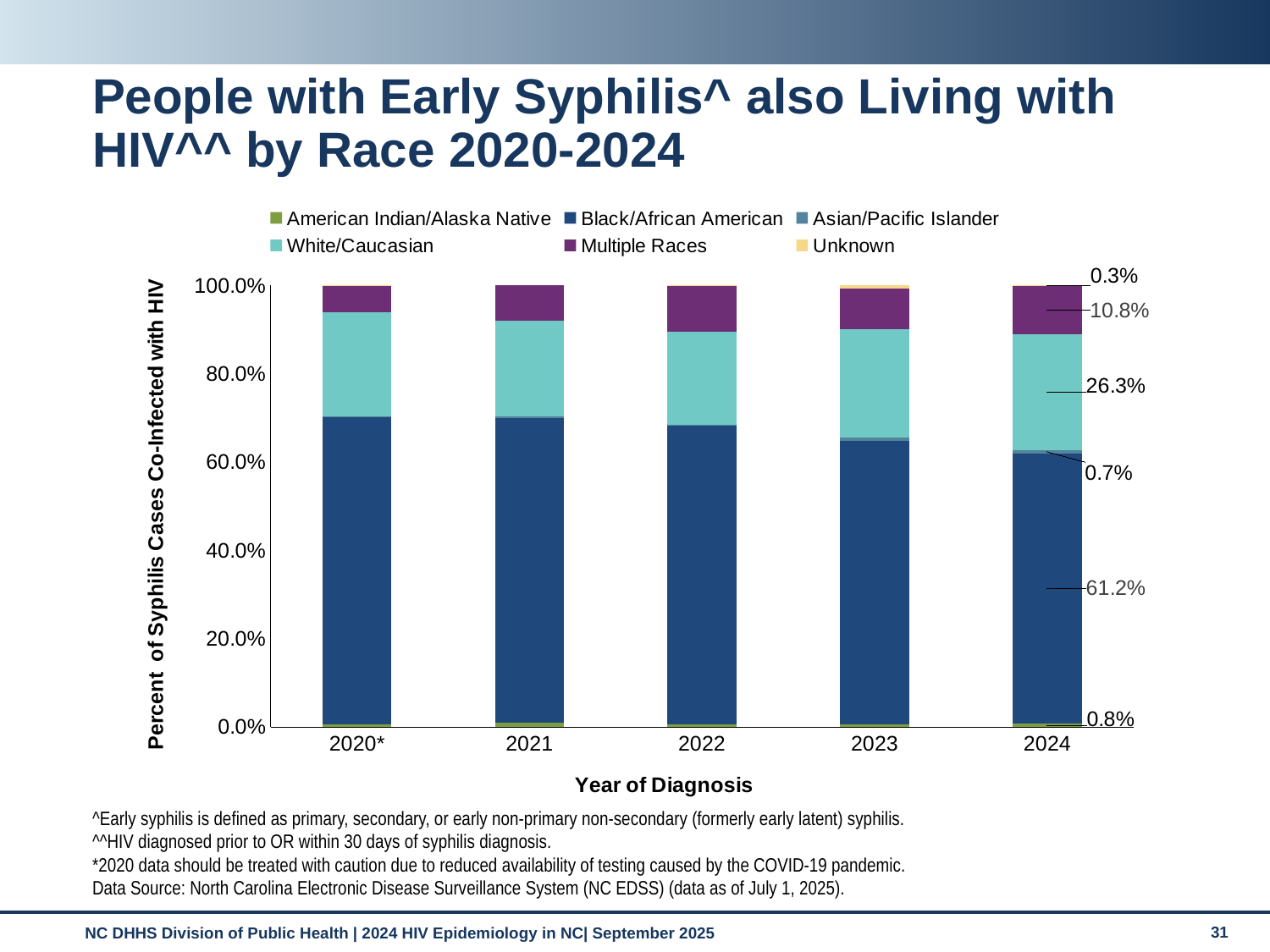
What is the White/Caucasian share shown for 2024? 26.3% What percentage of the 2024 bar is Black/African American? 61.2% Which race group has the smallest labelled share in 2024? Unknown Which race group has the largest share in the 2024 bar? Black/African American Does the Black/African American share rise or fall from 2020* to 2024? fall In 2024, how many percentage points larger is the Black/African American share than the White/Caucasian share? 34.9 percentage points In 2024, which is larger: the White/Caucasian share or the Multiple Races share? White/Caucasian What value is labelled for Multiple Races in 2024? 10.8% What is the Unknown share labelled for 2024? 0.3% What is the Asian/Pacific Islander value labelled for 2024? 0.7% Is the Black/African American share in 2020* greater or less than 60%? greater How many series does the legend list? 6